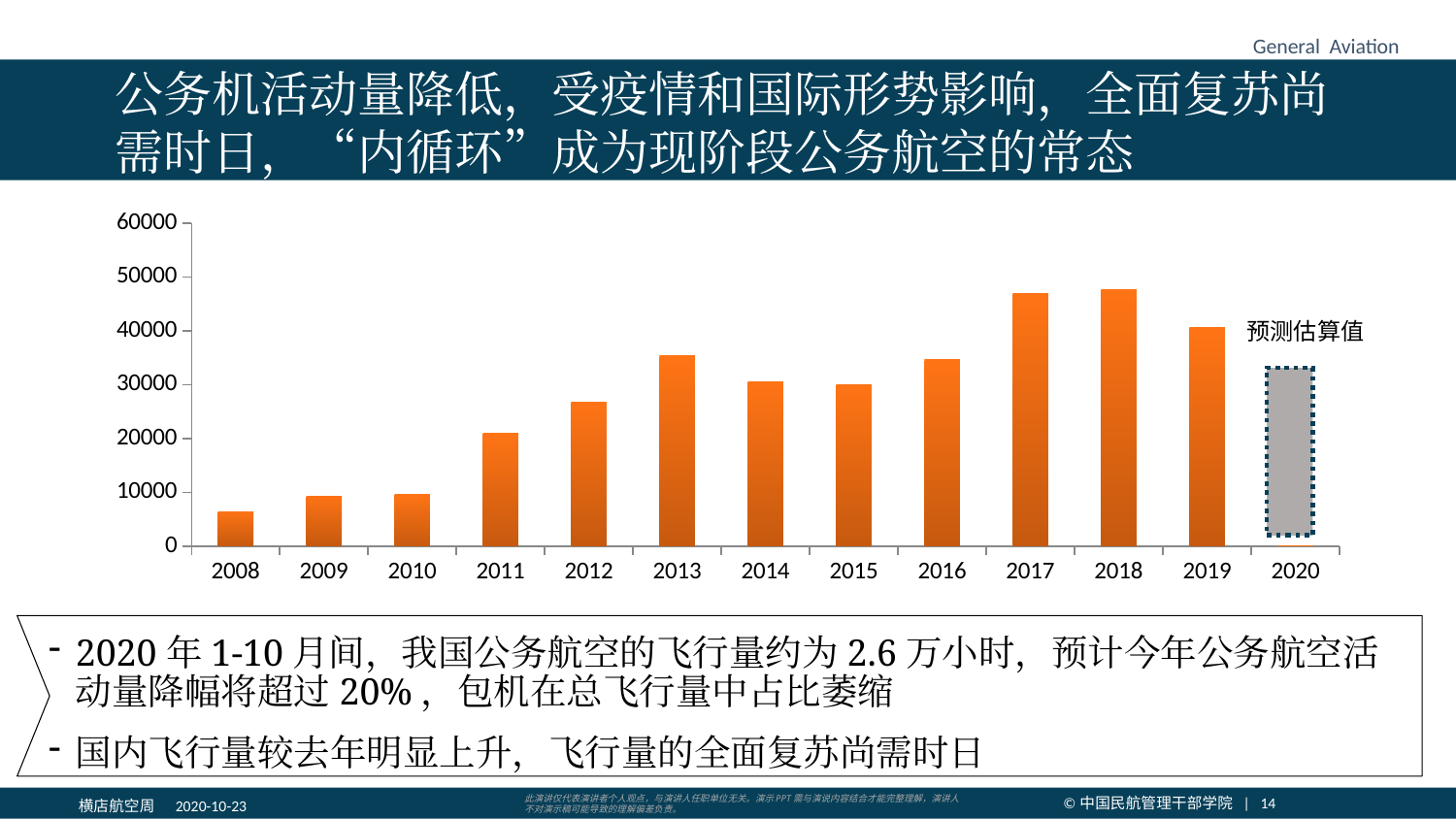
Do the values rise or fall from 2008 to 2013? rise Is the value for 2008 greater or less than 10000? less How many years are shown on the x axis of the chart? 13 Is the value for 2019 greater or less than 50000? less Is the value for 2017 greater or less than 40000? greater Which is larger, the value for 2018 or the value for 2019? 2018 Which is larger, the value for 2013 or the value for 2014? 2013 What kind of chart is shown on the slide? bar chart What label is attached to the dashed grey bar for 2020? 预测估算值